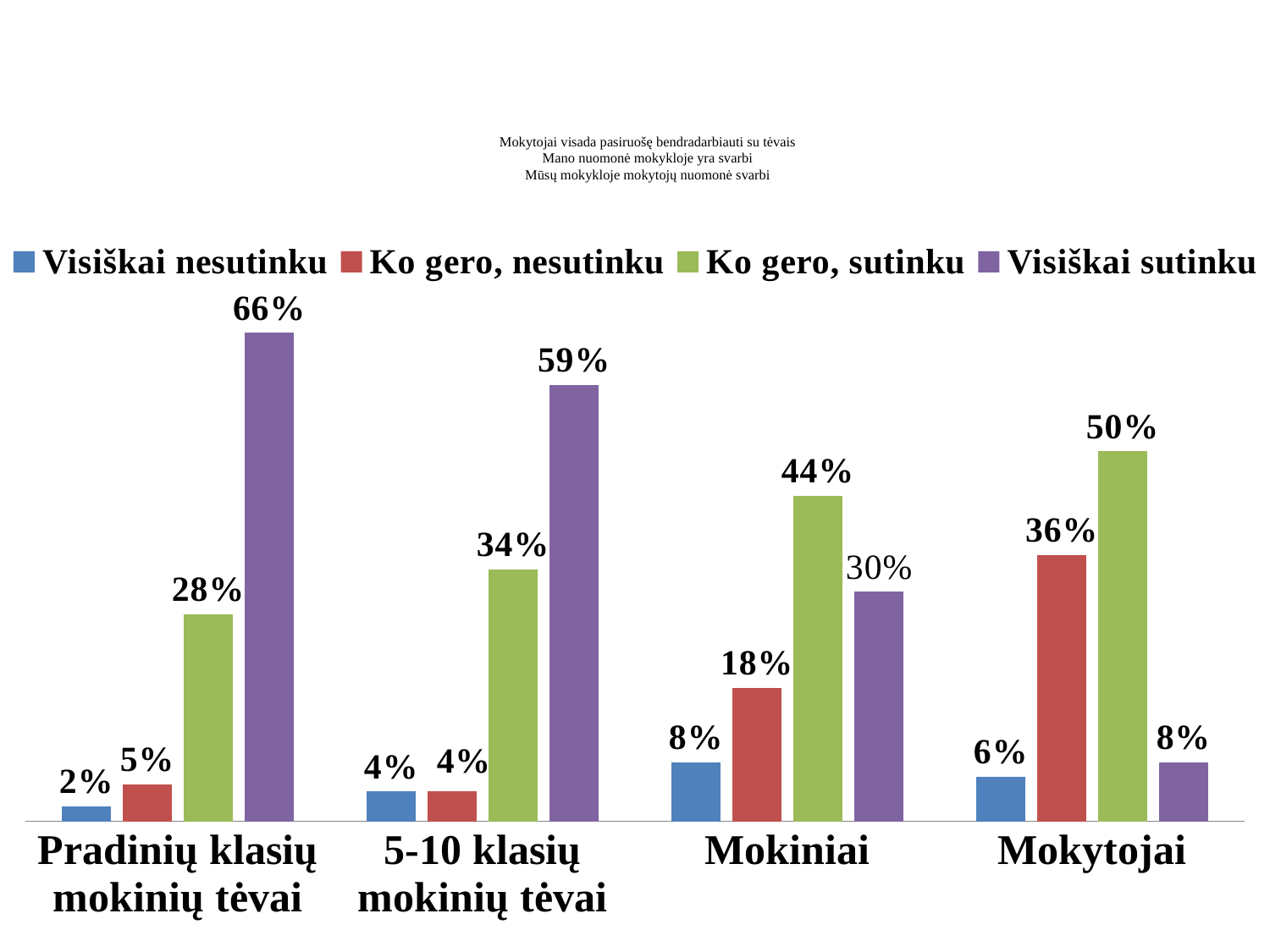
What is the value for "Visiškai nesutinku" in the "5-10 klasių mokinių tėvai" category? 4% What is the value for "Ko gero, nesutinku" in the "Mokiniai" category? 18% What is the value for "Ko gero, sutinku" in the "Mokytojai" category? 50% Which category has the lowest value for "Visiškai nesutinku"? Pradinių klasių mokinių tėvai How many categories are shown on the x axis? 4 Which is larger in the "Mokiniai" category: "Ko gero, sutinku" or "Visiškai sutinku"? Ko gero, sutinku What kind of chart is shown on the slide? Bar chart Which category has the highest value for "Visiškai sutinku"? Pradinių klasių mokinių tėvai How many series does the legend list? 4 Which colour represents the "Ko gero, sutinku" series? Green What is the value for "Visiškai sutinku" in the "Pradinių klasių mokinių tėvai" category? 66% What is the difference between the "Visiškai sutinku" values for "Pradinių klasių mokinių tėvai" and "5-10 klasių mokinių tėvai"? 7%